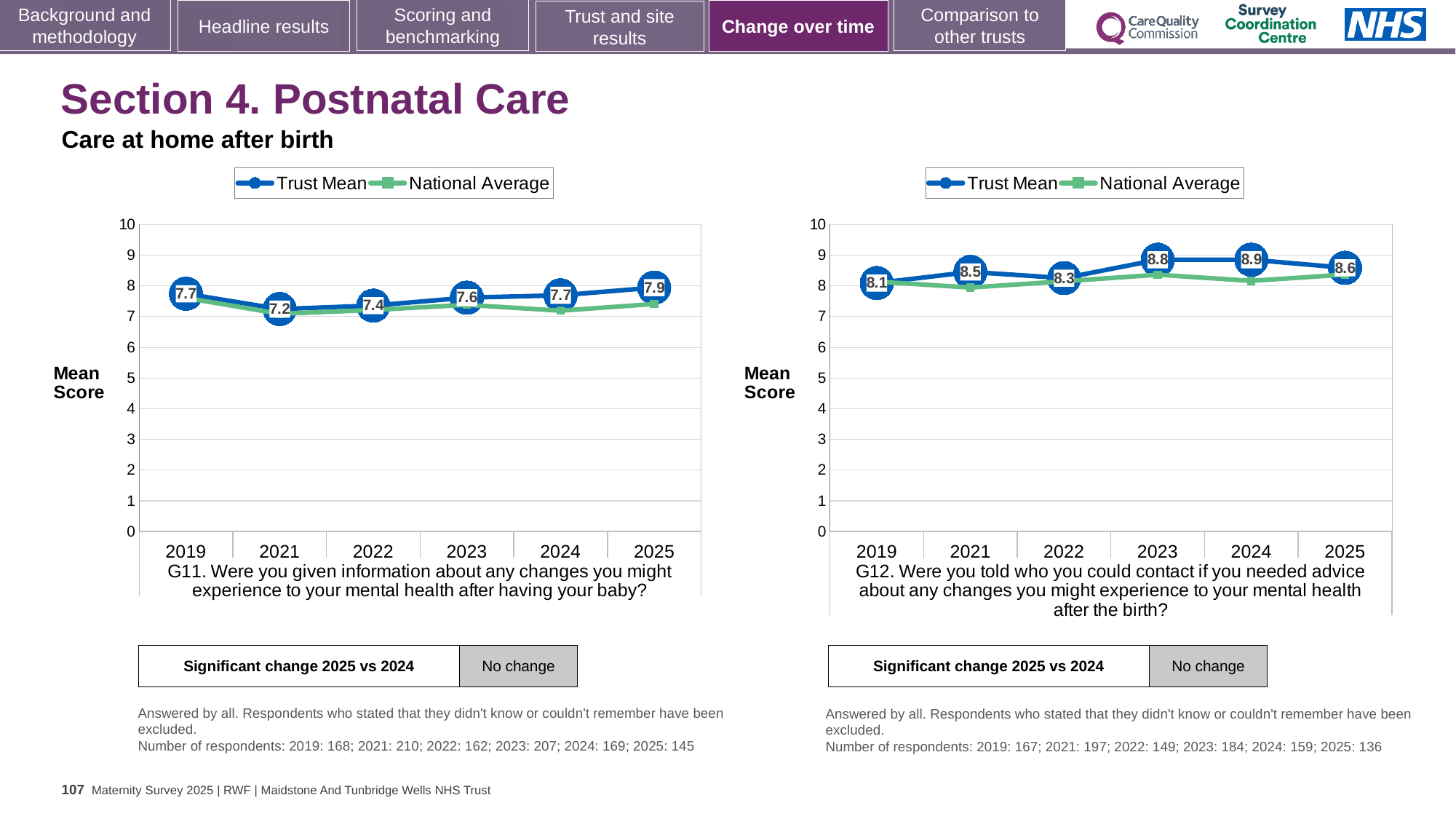
In the G11 chart on the left, which year has the lowest Trust Mean? 2021 In the G12 chart on the right, how many years are plotted on the x axis? 6 In the G12 chart on the right, which year has the highest Trust Mean? 2024 In the G11 chart on the left, what is the Trust Mean for 2025? 7.9 In the G11 chart on the left, which year has the highest Trust Mean? 2025 In the G12 chart on the right, is the Trust Mean for 2023 larger or smaller than the Trust Mean for 2022? larger In the G12 chart on the right, what is the Trust Mean for 2024? 8.9 In the G12 chart on the right, what is the Trust Mean for 2019? 8.1 What type of chart is the G12 chart on the right? Line chart In the G11 chart on the left, what is the Trust Mean for 2021? 7.2 How many series does the legend of the G11 chart on the left list? 2 In the G11 chart on the left, what is the difference between the Trust Mean in 2025 and in 2021? 0.7